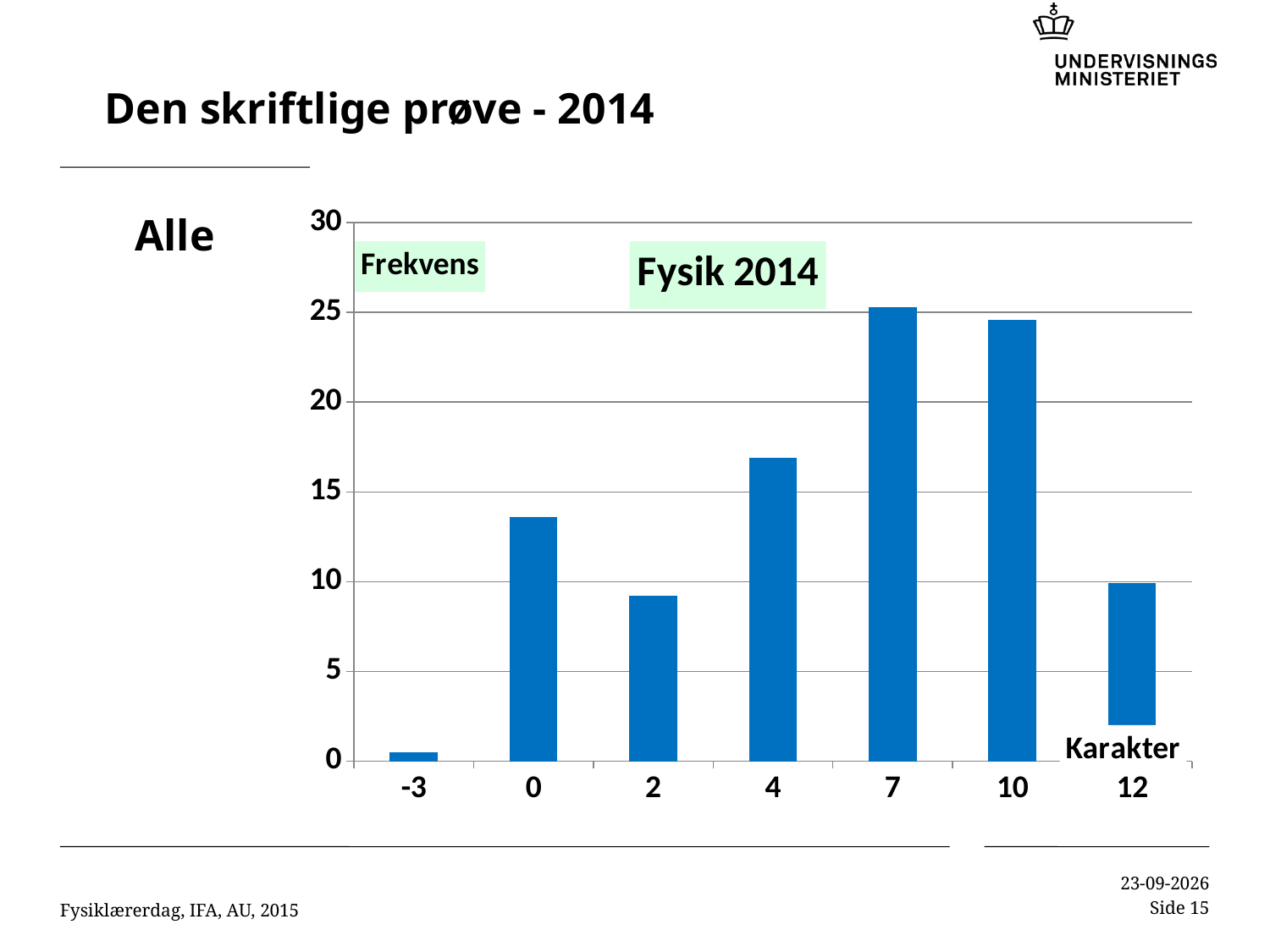
Which grade has the higher frequency, 4 or 7? 7 What is the title shown inside the chart area? Fysik 2014 Is the frequency for grade 4 greater or less than 15? greater What kind of chart is shown on the slide? bar chart How many grade categories (Karakter) are shown on the x axis of the chart? 7 Which grade category has the lowest frequency in the chart? -3 Is the frequency for grade 10 greater or less than 20? greater Do the frequencies rise or fall from grade 7 to grade 12? fall Which grade has the higher frequency, 0 or 2? 0 Is the frequency for grade 2 greater or less than 10? less